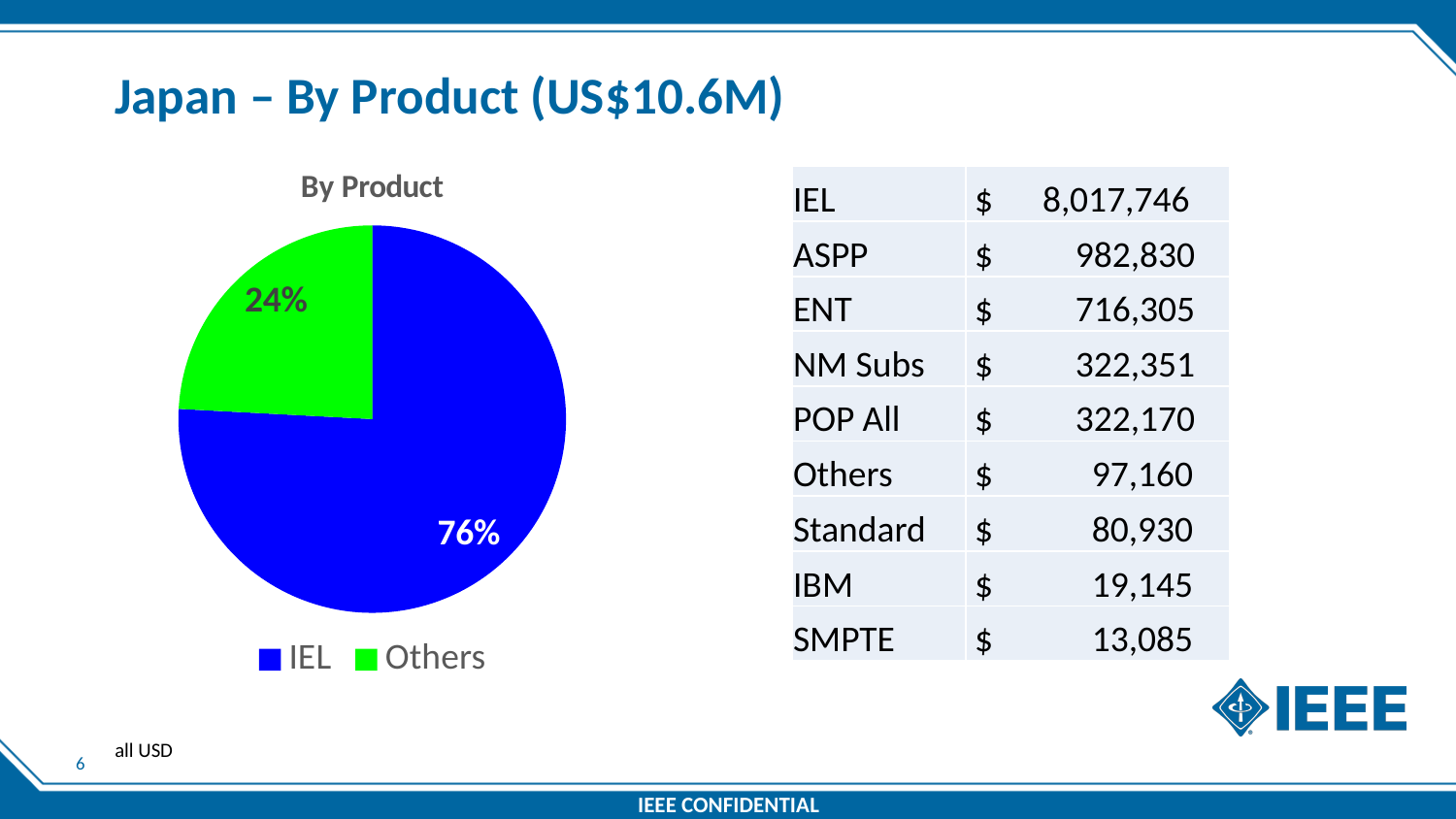
Which slice of the pie chart is the smallest? Others How many entries does the pie chart legend list? 2 What share of the pie does IEL represent? 76% Which is larger in the pie chart, IEL or Others? IEL Is the share for Others greater or less than 50%? less What is the difference in percentage points between the IEL slice and the Others slice? 52 What colour is the IEL slice in the pie chart? blue What kind of chart is shown on the slide? pie chart How many slices does the pie chart have? 2 What is the title of the pie chart? By Product What share of the pie does Others represent? 24% Which slice of the pie chart is the largest? IEL